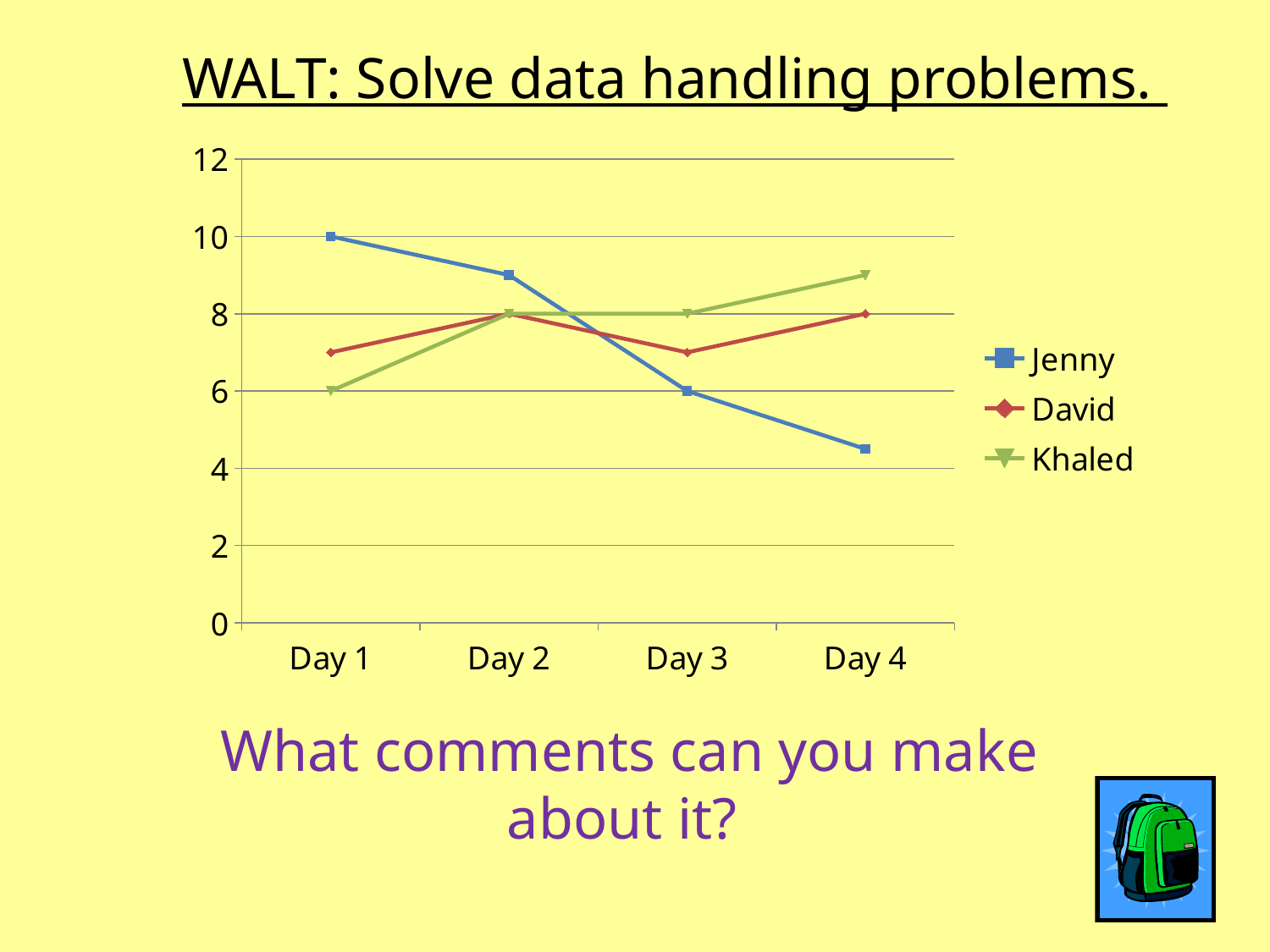
Is Jenny's value on Day 4 greater or less than 6? less What is Khaled's value on Day 1? 6 How many days are shown on the x axis? 4 On which day is Jenny's value highest? Day 1 What is Jenny's value on Day 1? 10 On Day 4, who has the larger value, Jenny or Khaled? Khaled Does Jenny's line rise or fall from Day 1 to Day 4? fall How many series does the legend list? 3 What is David's value on Day 4? 8 What kind of chart is shown on the slide? line chart What is the difference between Jenny's value on Day 1 and her value on Day 3? 4 Is Khaled's value on Day 4 greater or less than 8? greater